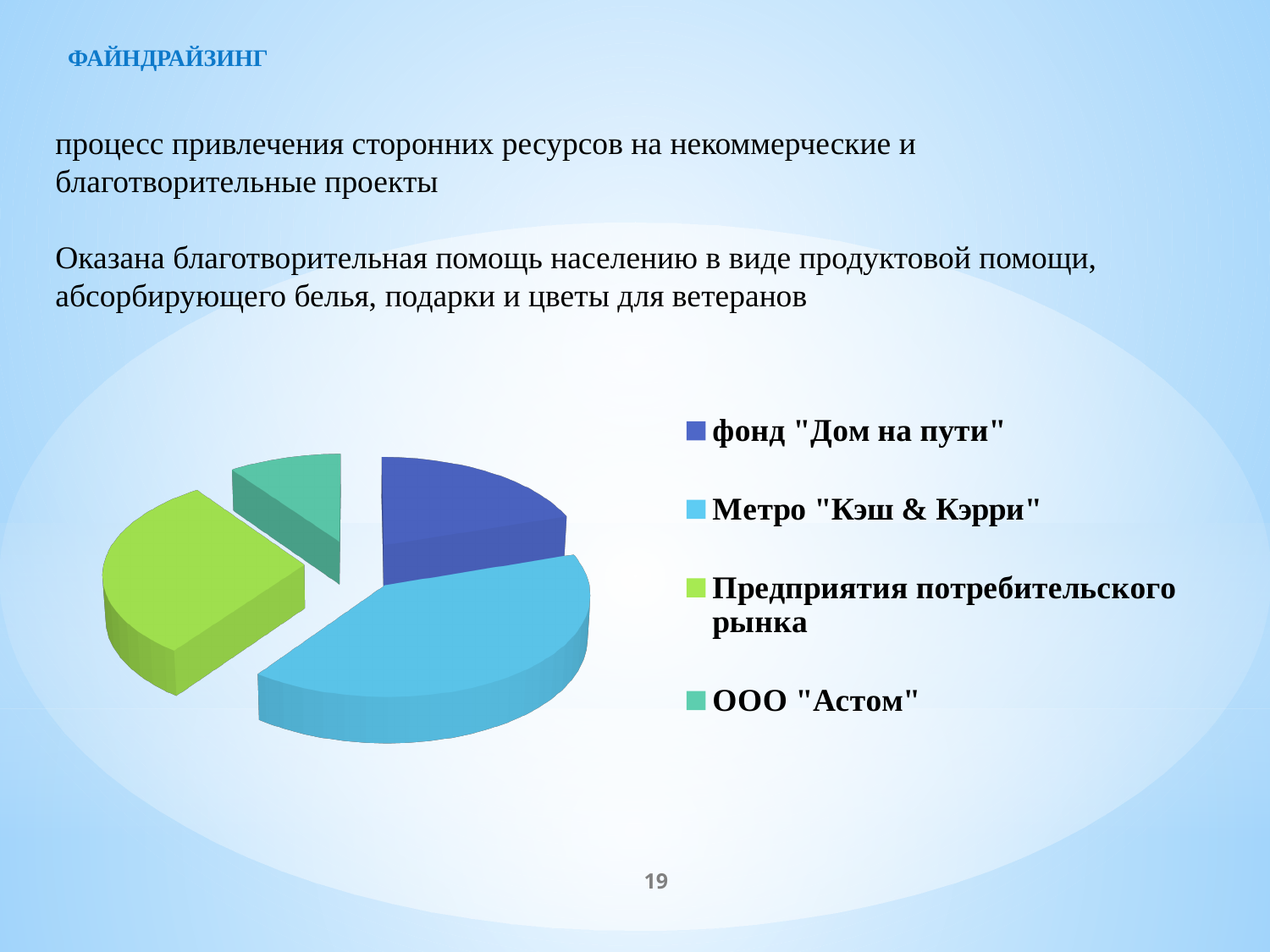
Which legend entry is shown in green in the pie chart? Предприятия потребительского рынка Which slice is larger: Метро "Кэш & Кэрри" or фонд "Дом на пути"? Метро "Кэш & Кэрри" Which category has the largest slice in the pie chart? Метро "Кэш & Кэрри" What colour is the slice for Метро "Кэш & Кэрри" in the pie chart? light blue How many entries does the legend of the pie chart list? 4 Which slice is larger: фонд "Дом на пути" or ООО "Астом"? фонд "Дом на пути" Which slice is larger: Метро "Кэш & Кэрри" or ООО "Астом"? Метро "Кэш & Кэрри" Which category has the smallest slice in the pie chart? ООО "Астом" How many slices does the pie chart have? 4 What kind of chart is shown on the slide? pie chart